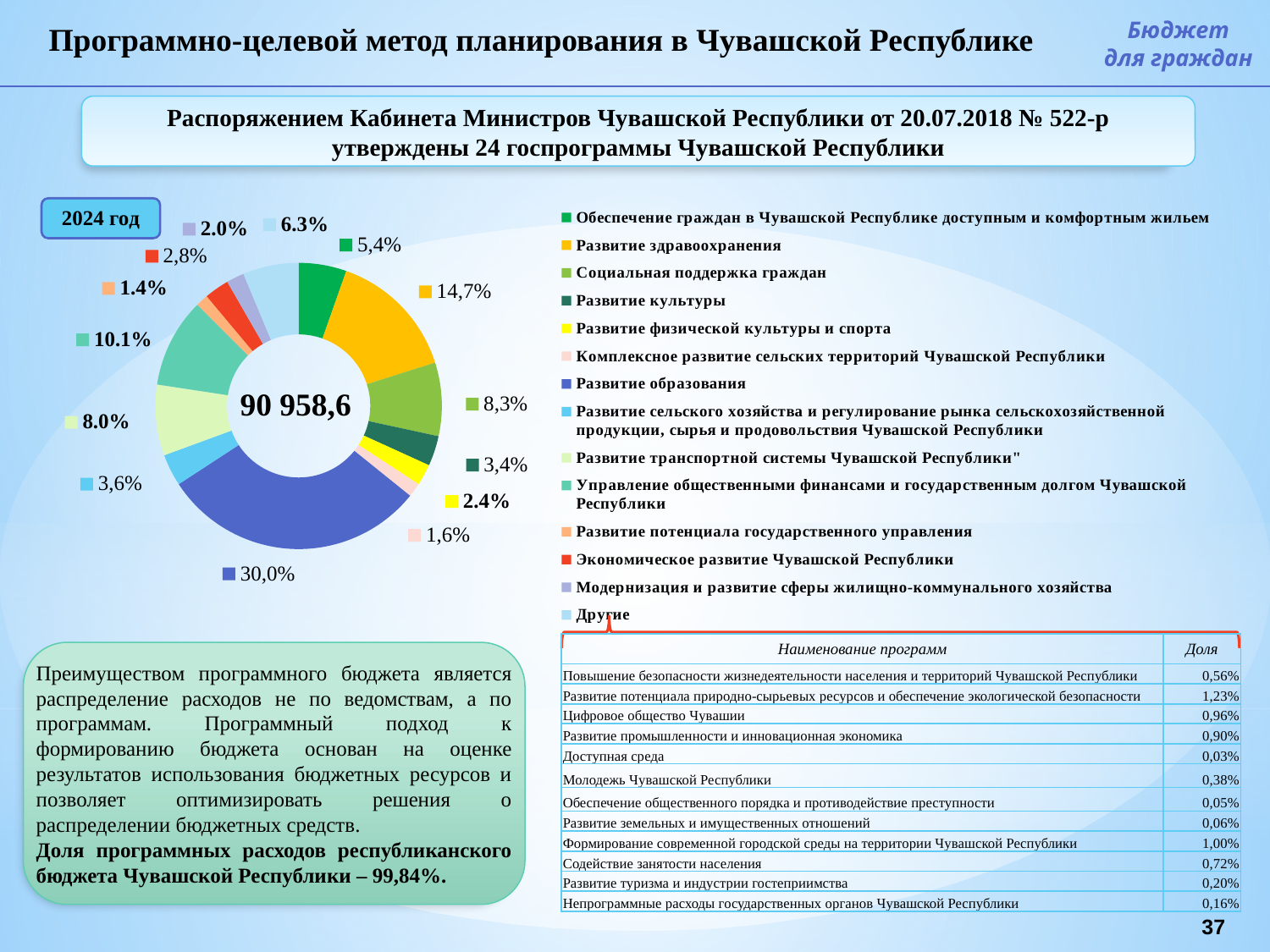
Which has the larger share: "Развитие культуры" or "Развитие сельского хозяйства и регулирование рынка сельскохозяйственной продукции, сырья и продовольствия Чувашской Республики"? Развитие сельского хозяйства и регулирование рынка сельскохозяйственной продукции, сырья и продовольствия Чувашской Республики What year does the label next to the doughnut chart refer to? 2024 год Which program has the largest share in the doughnut chart? Развитие образования What is the difference between the shares of "Развитие образования" and "Развитие здравоохранения"? 15,3% What share does the chart show for "Управление общественными финансами и государственным долгом Чувашской Республики"? 10.1% What share does the chart show for "Социальная поддержка граждан"? 8,3% What share does the chart show for "Развитие здравоохранения"? 14,7% Which program has the smallest share in the doughnut chart? Развитие потенциала государственного управления How many entries does the legend of the doughnut chart list? 14 What kind of chart is shown on the slide? doughnut (pie) chart What value is shown in the centre of the doughnut chart? 90 958,6 What share does the chart show for "Развитие образования"? 30,0%